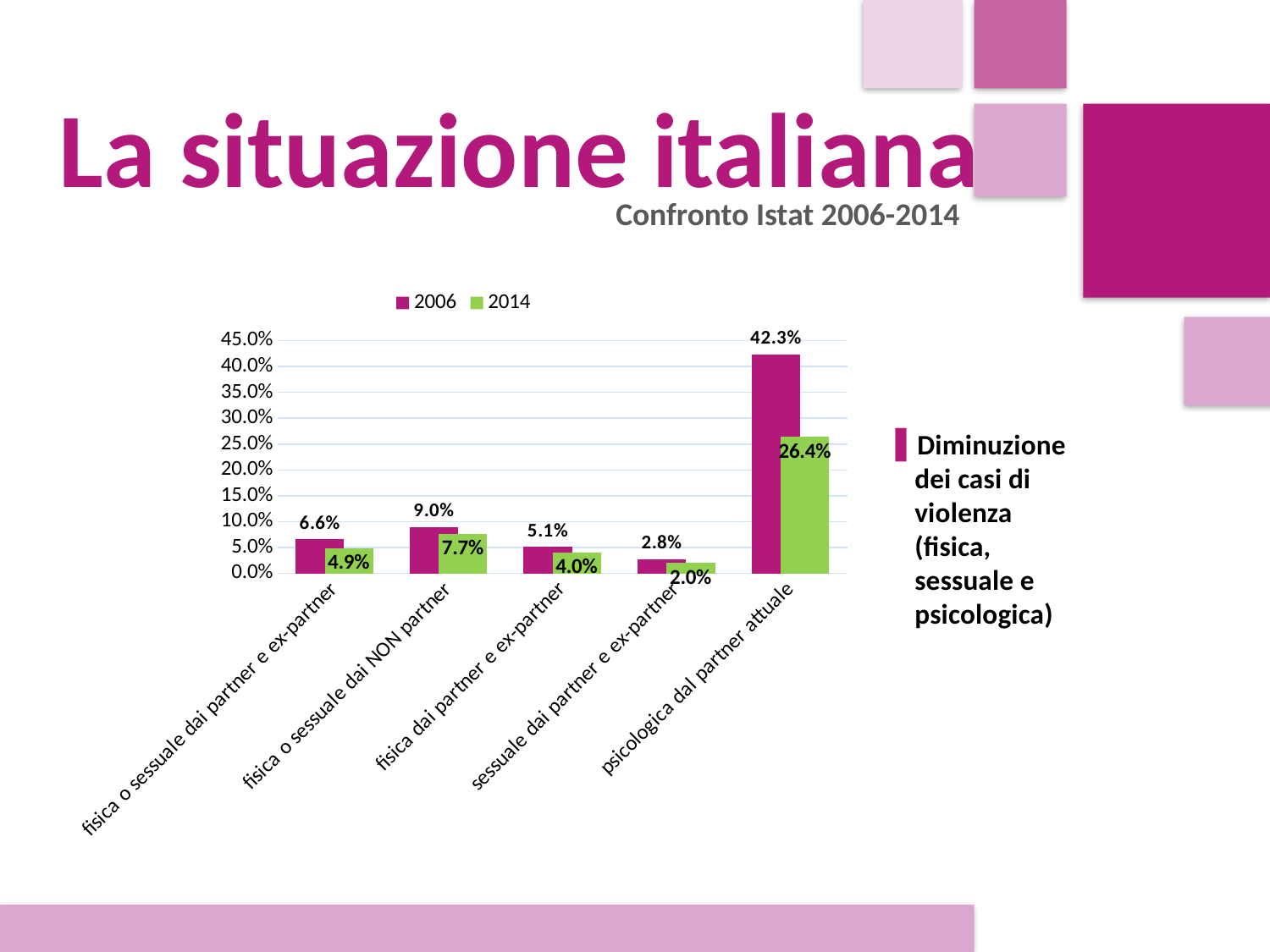
What is the 2006 value for 'fisica dai partner e ex-partner'? 5.1% What is the 2014 value for 'sessuale dai partner e ex-partner'? 2.0% What is the 2006 value for 'psicologica dal partner attuale'? 42.3% Which is larger: the 2006 value for 'fisica o sessuale dai NON partner' or the 2006 value for 'fisica o sessuale dai partner e ex-partner'? fisica o sessuale dai NON partner How many series does the chart legend list? 2 How many categories are shown on the x axis of the chart? 5 What is the difference between the 2006 and 2014 values for 'fisica o sessuale dai partner e ex-partner'? 1.7 percentage points What is the 2014 value for 'fisica o sessuale dai NON partner'? 7.7% Which category has the highest 2006 value? psicologica dal partner attuale What kind of chart is shown on the slide? Bar chart What is the difference between the 2006 and 2014 values for 'psicologica dal partner attuale'? 15.9 percentage points Which category has the lowest 2014 value? sessuale dai partner e ex-partner